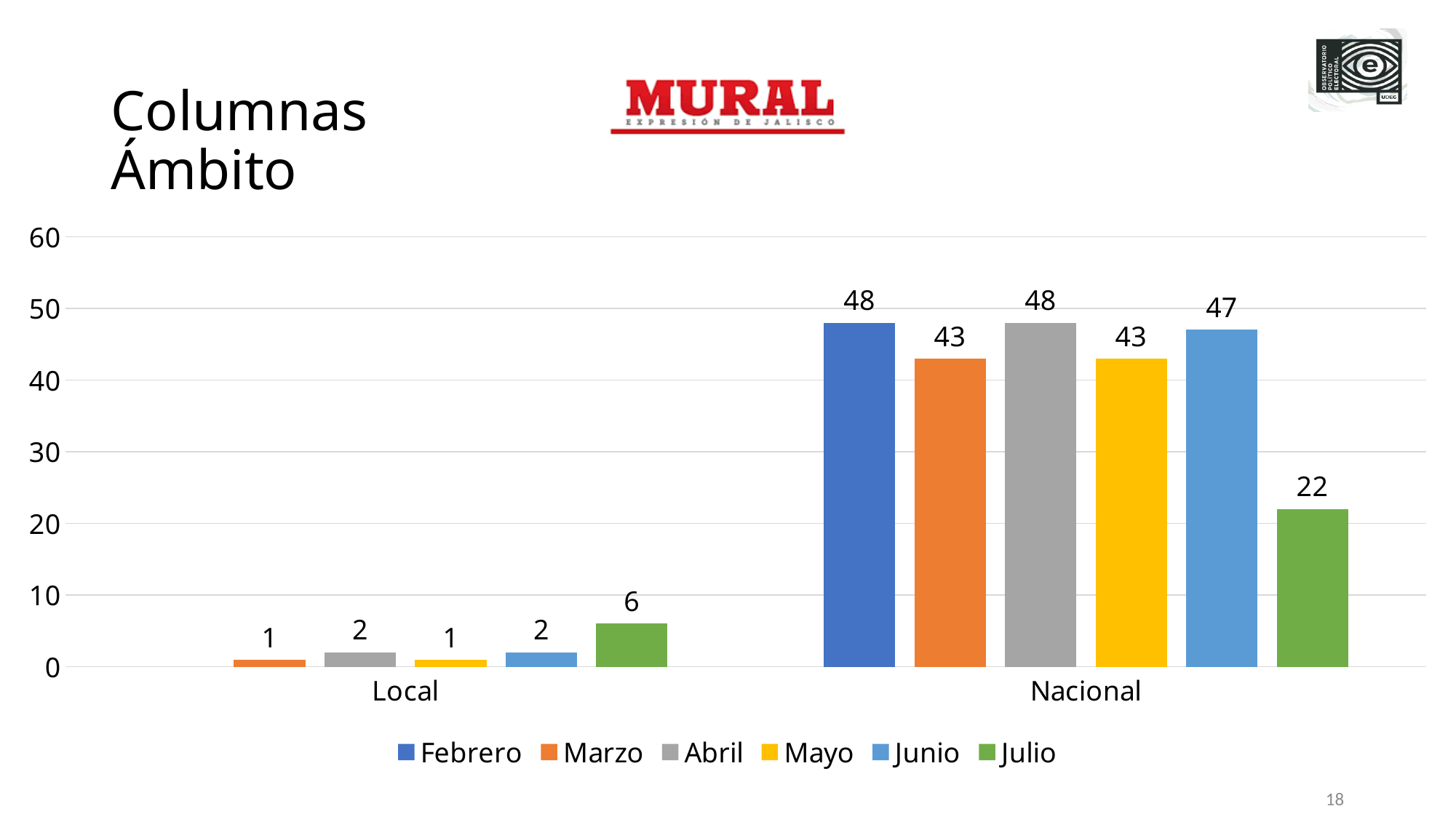
What is the value for Marzo in the Nacional category? 43 How many series does the legend list? 6 What is the value for Julio in the Nacional category? 22 What is the difference between the Febrero and Julio values in the Nacional category? 26 What is the value for Abril in the Local category? 2 What colour represents Mayo in the legend? Yellow Which series has the highest value in the Local category? Julio Which series has the lowest value in the Nacional category? Julio How many categories are shown on the x axis? 2 What is the value for Julio in the Local category? 6 Which is larger in the Nacional category, Junio or Mayo? Junio What kind of chart is shown on the slide? Bar chart